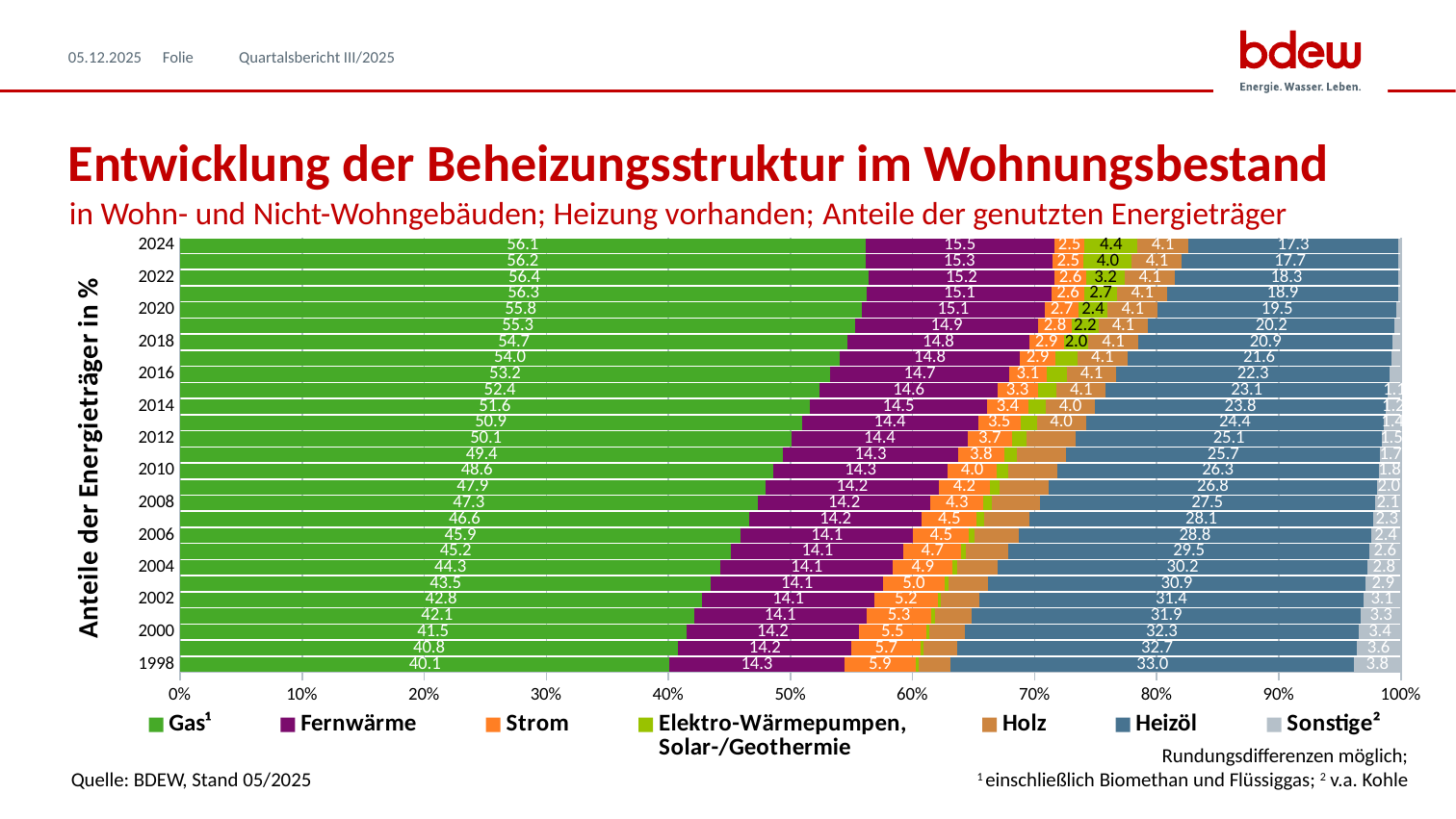
How many series does the legend list? 7 What kind of chart is shown on the slide? stacked bar chart In which year is the share of Gas the lowest? 1998 Which has the larger share in 2024, Gas or Heizöl? Gas What is the share of Strom in 1998? 5.9 What is the share of Elektro-Wärmepumpen, Solar-/Geothermie in 2024? 4.4 By how many percentage points did the share of Gas increase from 1998 to 2024? 16.0 What is the share of Fernwärme in 2024? 15.5 What is the share of Heizöl in 1998? 33.0 Does the share of Heizöl rise or fall from 1998 to 2024? fall In which year is the share of Gas the highest? 2022 What is the share of Gas in 2024? 56.1